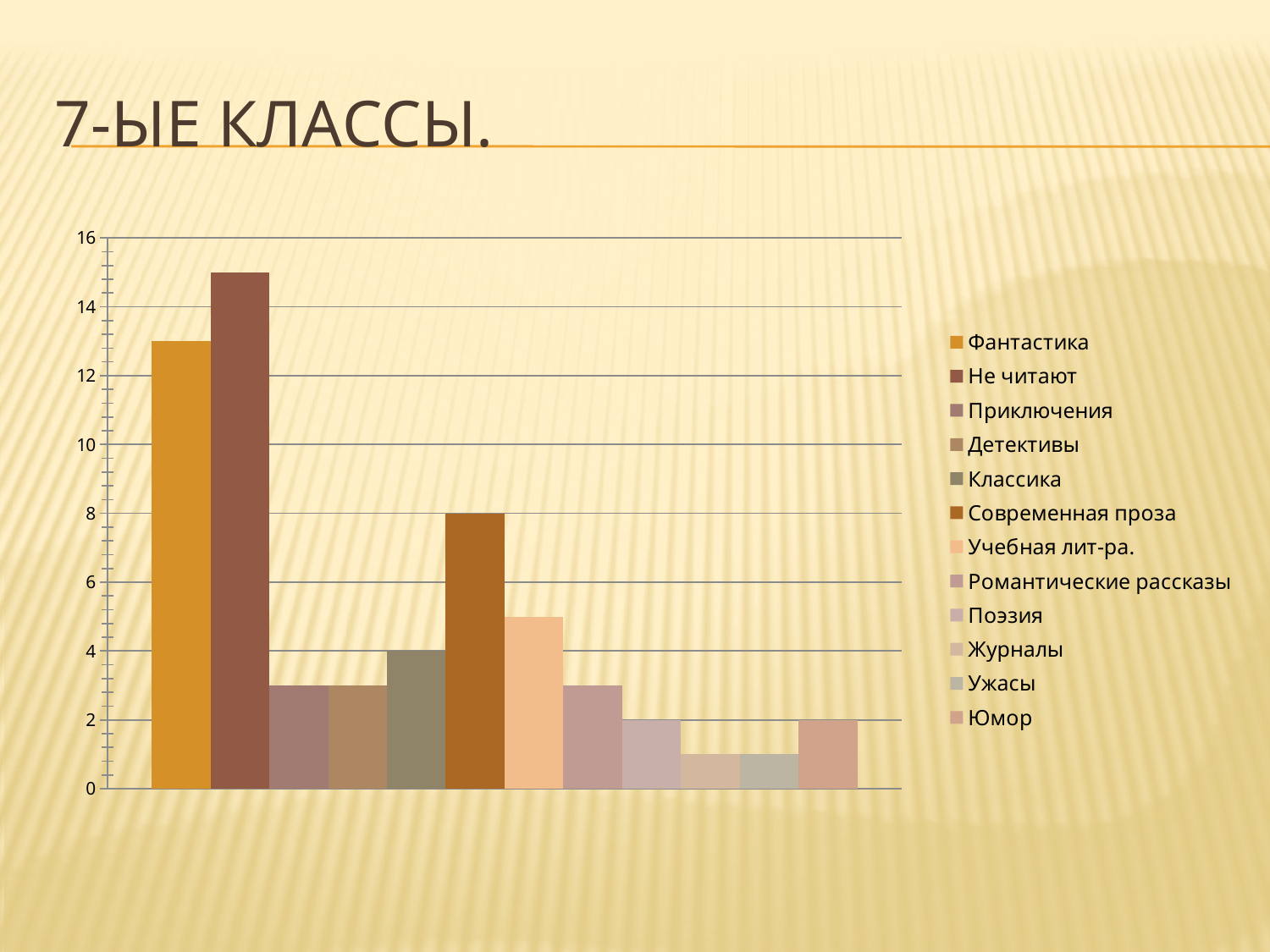
What is the value for Поэзия? 2 Which is larger, the value for Фантастика or the value for Современная проза? Фантастика What kind of chart is shown on the slide? bar chart Which series has the highest bar? Не читают How many series does the legend list? 12 Is the value for Учебная лит-ра. greater or less than 4? greater Is the value for Фантастика greater or less than 12? greater What is the title of the slide containing the chart? 7-ые классы. What is the difference between the values for Современная проза and Классика? 4 What is the value for Современная проза? 8 What is the value for Классика? 4 Is the value for Журналы greater or less than 2? less